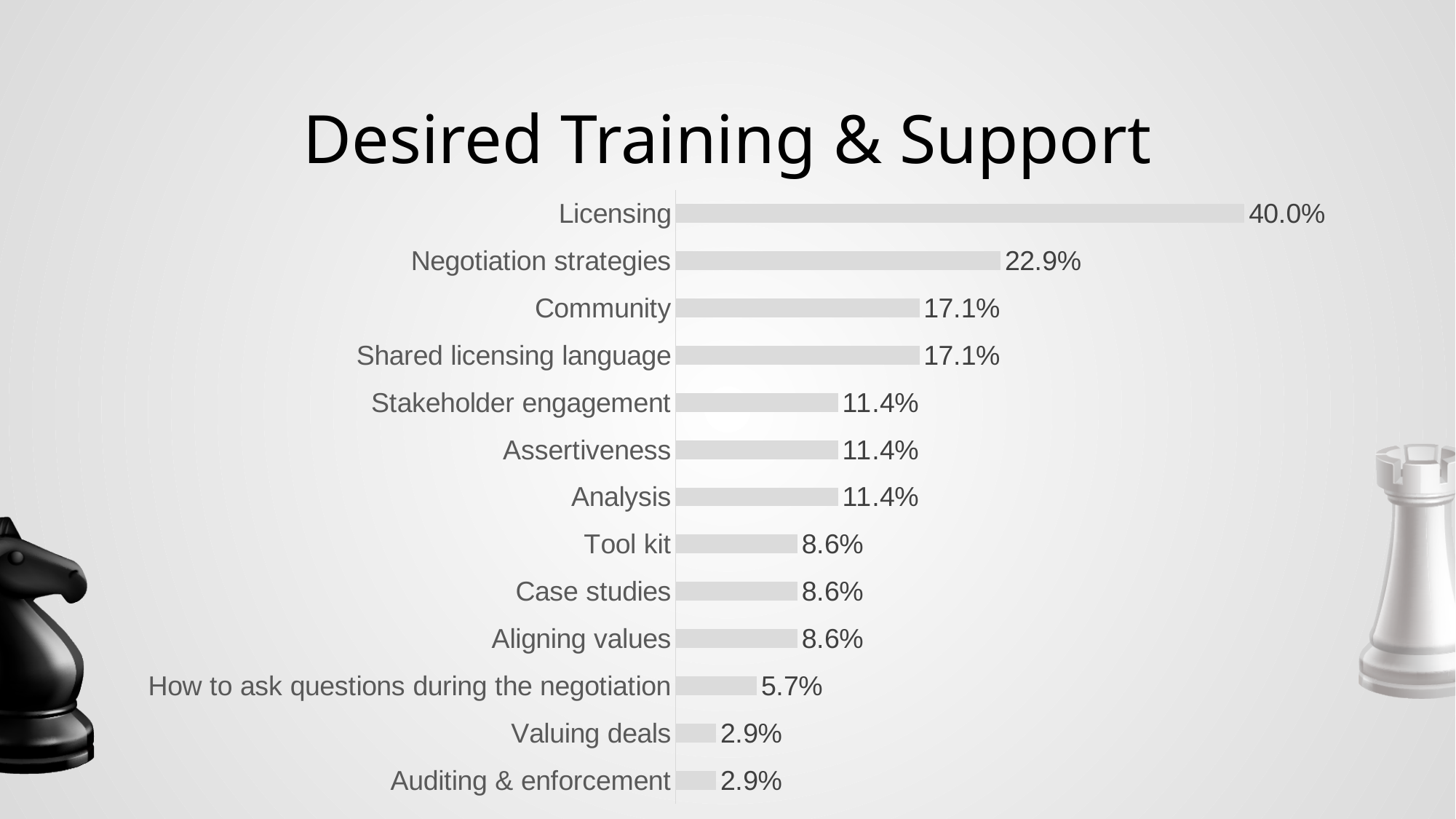
What is the value for How to ask questions during the negotiation? 5.7% What is the value for Licensing? 40.0% What is the value for Stakeholder engagement? 11.4% Which is larger, the value for Case studies or the value for Valuing deals? Case studies What is the title of the slide? Desired Training & Support What kind of chart is shown on the slide? Bar chart What is the difference between the values for Community and Tool kit? 8.5% How many categories are shown in the chart? 13 Which category has the highest value? Licensing What is the difference between the values for Licensing and Negotiation strategies? 17.1% What is the value for Auditing & enforcement? 2.9% What is the value for Negotiation strategies? 22.9%